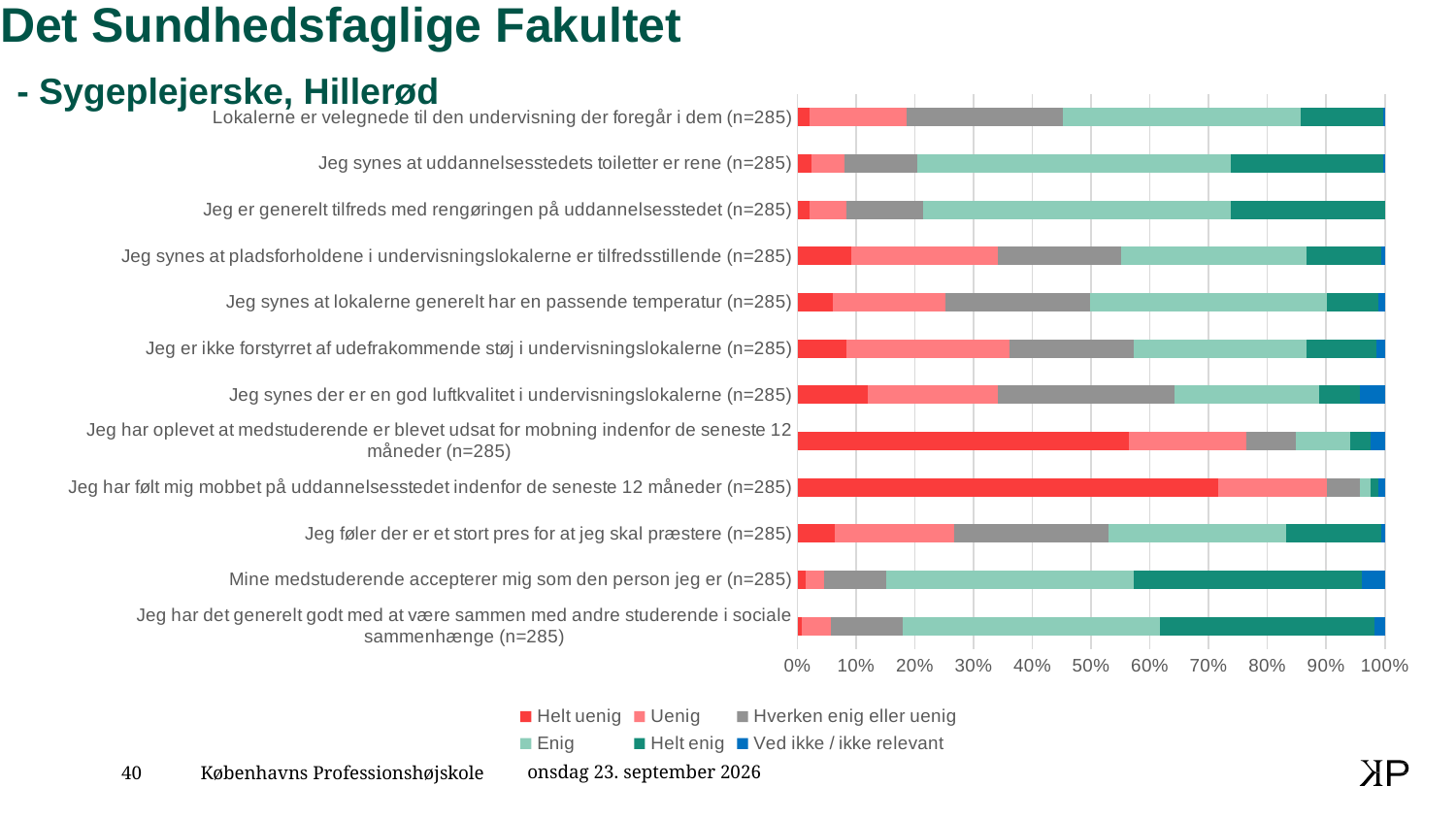
How many statements (categories) are plotted in the chart? 12 Is the 'Helt uenig' share for 'Jeg har oplevet at medstuderende er blevet udsat for mobning indenfor de seneste 12 måneder' greater or less than 50%? greater Which has the larger 'Helt uenig' share: 'Jeg synes der er en god luftkvalitet i undervisningslokalerne' or 'Jeg synes at lokalerne generelt har en passende temperatur'? Jeg synes der er en god luftkvalitet i undervisningslokalerne Is the 'Helt uenig' share for 'Jeg synes der er en god luftkvalitet i undervisningslokalerne' greater or less than 20%? less How many series does the chart legend list? 6 Which statement has the largest 'Helt uenig' share? Jeg har følt mig mobbet på uddannelsesstedet indenfor de seneste 12 måneder (n=285) What is the sample size (n) shown for each statement in the chart? 285 Is the 'Helt uenig' share for 'Jeg har følt mig mobbet på uddannelsesstedet indenfor de seneste 12 måneder' greater or less than 60%? greater Which legend entry is shown in red? Helt uenig What kind of chart is shown on the slide? Stacked bar chart Which has the larger 'Helt uenig' share: 'Jeg har følt mig mobbet på uddannelsesstedet indenfor de seneste 12 måneder' or 'Jeg har oplevet at medstuderende er blevet udsat for mobning indenfor de seneste 12 måneder'? Jeg har følt mig mobbet på uddannelsesstedet indenfor de seneste 12 måneder